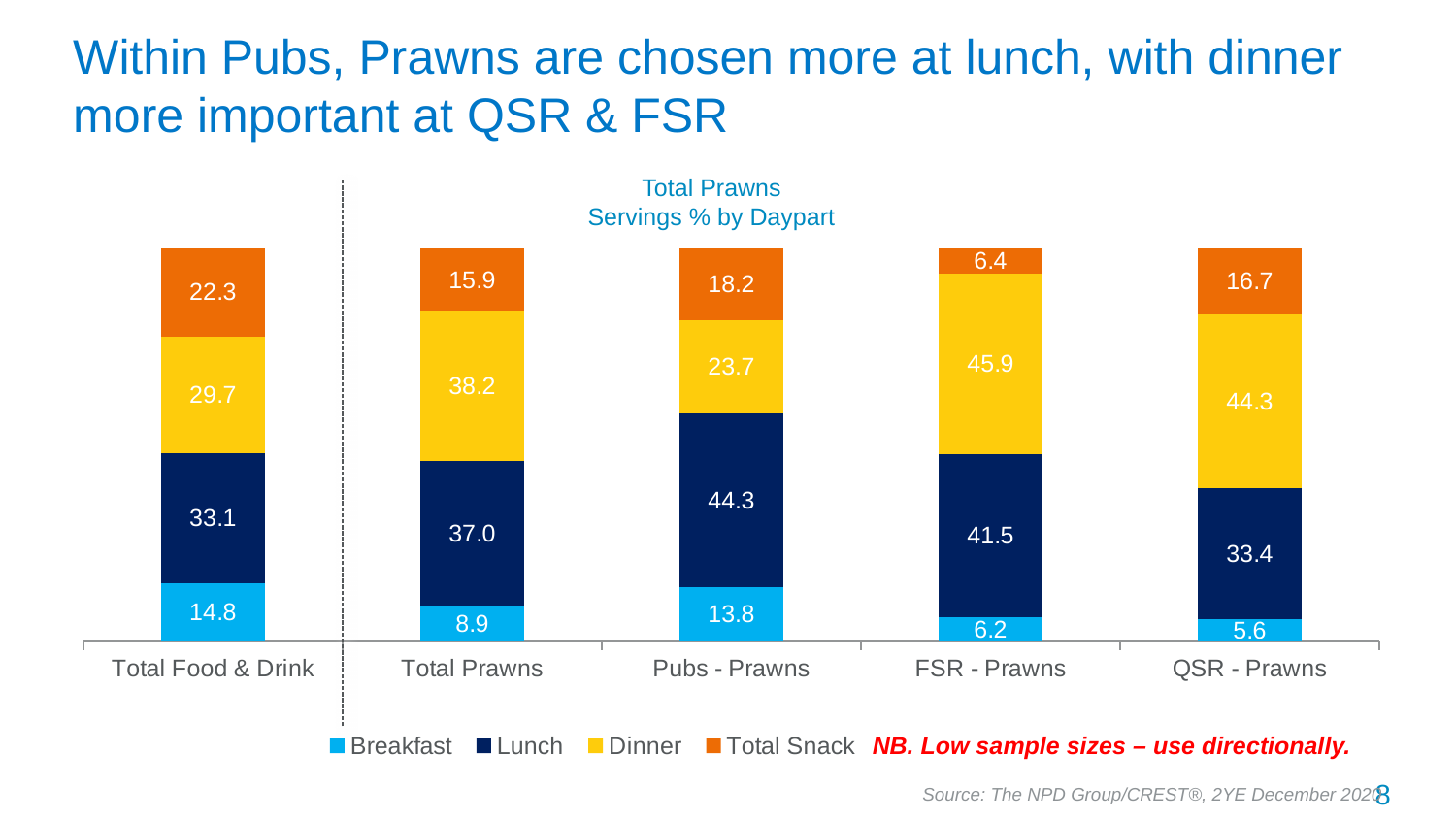
What kind of chart is shown? Stacked bar chart What is the difference between the Dinner values for Total Prawns and Pubs - Prawns? 14.5 What is the Lunch value for Pubs - Prawns? 44.3 What is the Breakfast value for QSR - Prawns? 5.6 What is the Dinner value for FSR - Prawns? 45.9 What is the Total Snack value for Total Food & Drink? 22.3 Which category has the lowest Breakfast value? QSR - Prawns Which category has the highest Lunch value? Pubs - Prawns How many series does the legend list? 4 How many categories are shown on the x axis? 5 Which is larger, the Total Snack value for Pubs - Prawns or for FSR - Prawns? Pubs - Prawns What is the total of the stacked bar for FSR - Prawns? 100.0